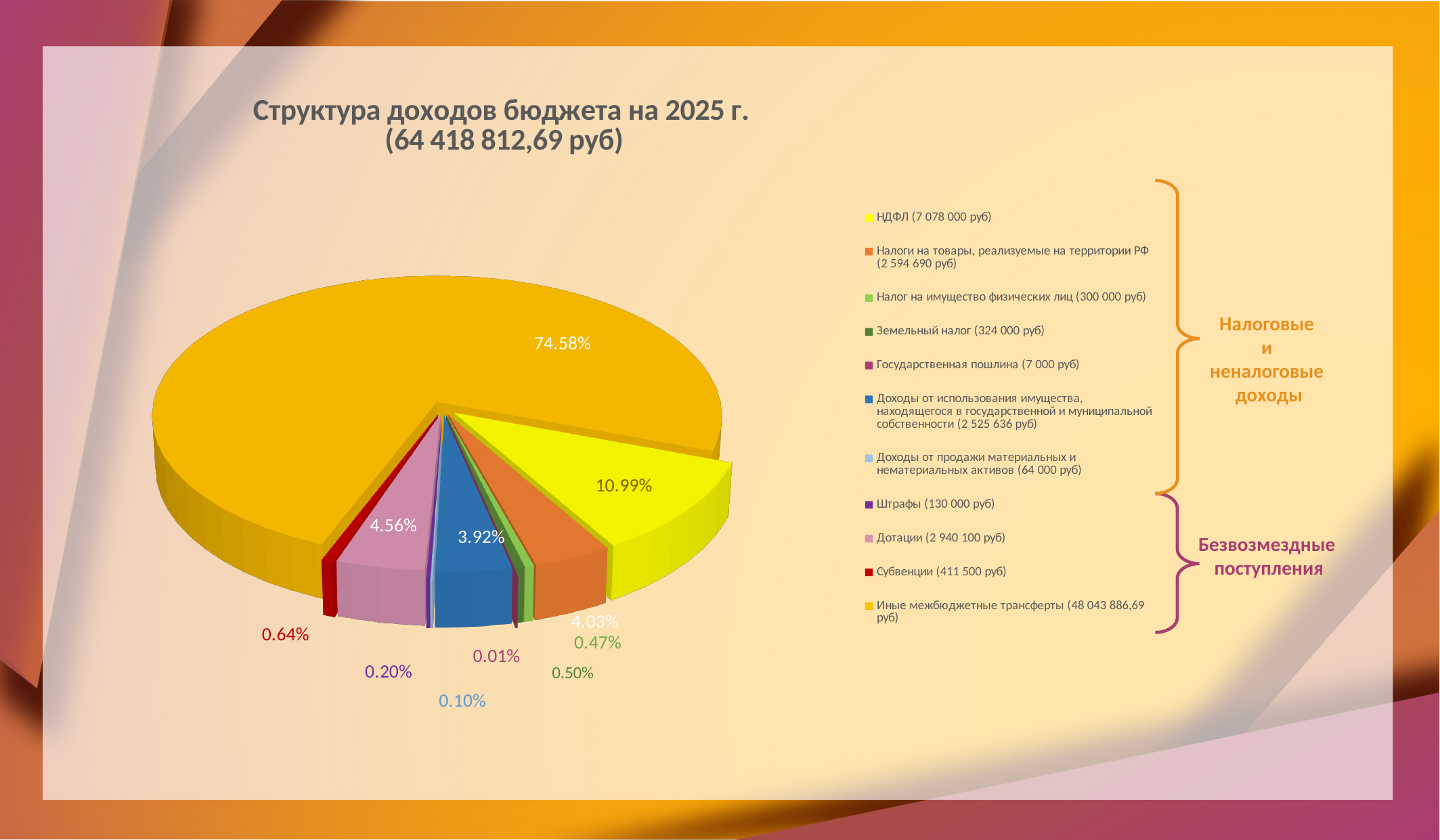
How many entries does the chart legend list? 11 What percentage is shown for Дотации? 4.56% Which slice is larger: Дотации or Налоги на товары, реализуемые на территории РФ? Дотации What kind of chart is shown on the slide? Pie chart What percentage is shown for НДФЛ? 10.99% According to the legend, what amount in rubles is given for Субвенции? 411 500 руб What is the difference in percentage points between the Иные межбюджетные трансферты slice and the НДФЛ slice? 63.59 Which category has the smallest share of the pie? Государственная пошлина What share of the pie does the largest slice (Иные межбюджетные трансферты) take? 74.58% What is the title of the chart? Структура доходов бюджета на 2025 г. (64 418 812,69 руб) What percentage is shown for Доходы от использования имущества, находящегося в государственной и муниципальной собственности? 3.92% Which category has the largest share of the pie? Иные межбюджетные трансферты